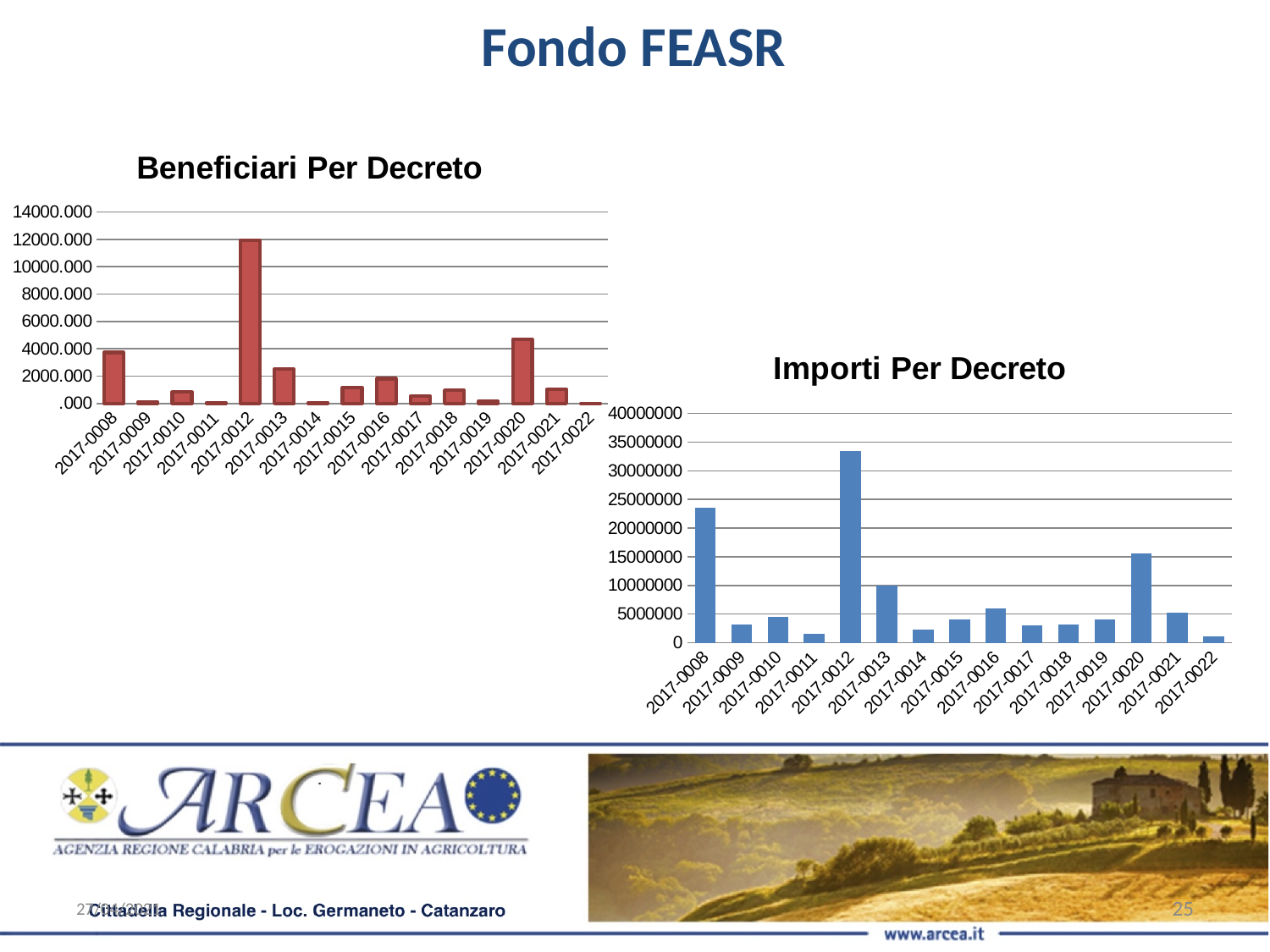
In the "Importi Per Decreto" chart, is the value for 2017-0012 greater or less than 30000000? greater In the "Importi Per Decreto" chart, which is larger, the value for 2017-0008 or the value for 2017-0020? 2017-0008 In the "Beneficiari Per Decreto" chart, is the value for 2017-0012 greater or less than 10000.000? greater In the "Beneficiari Per Decreto" chart, which is larger, the value for 2017-0020 or the value for 2017-0013? 2017-0020 What kind of chart is the "Beneficiari Per Decreto" chart? bar chart How many categories are shown on the x axis of the "Importi Per Decreto" chart? 15 In the "Importi Per Decreto" chart, which category has the highest value? 2017-0012 In the "Importi Per Decreto" chart, is the value for 2017-0008 greater or less than 20000000? greater In the "Beneficiari Per Decreto" chart, which category has the highest value? 2017-0012 What colour are the bars in the "Importi Per Decreto" chart? blue